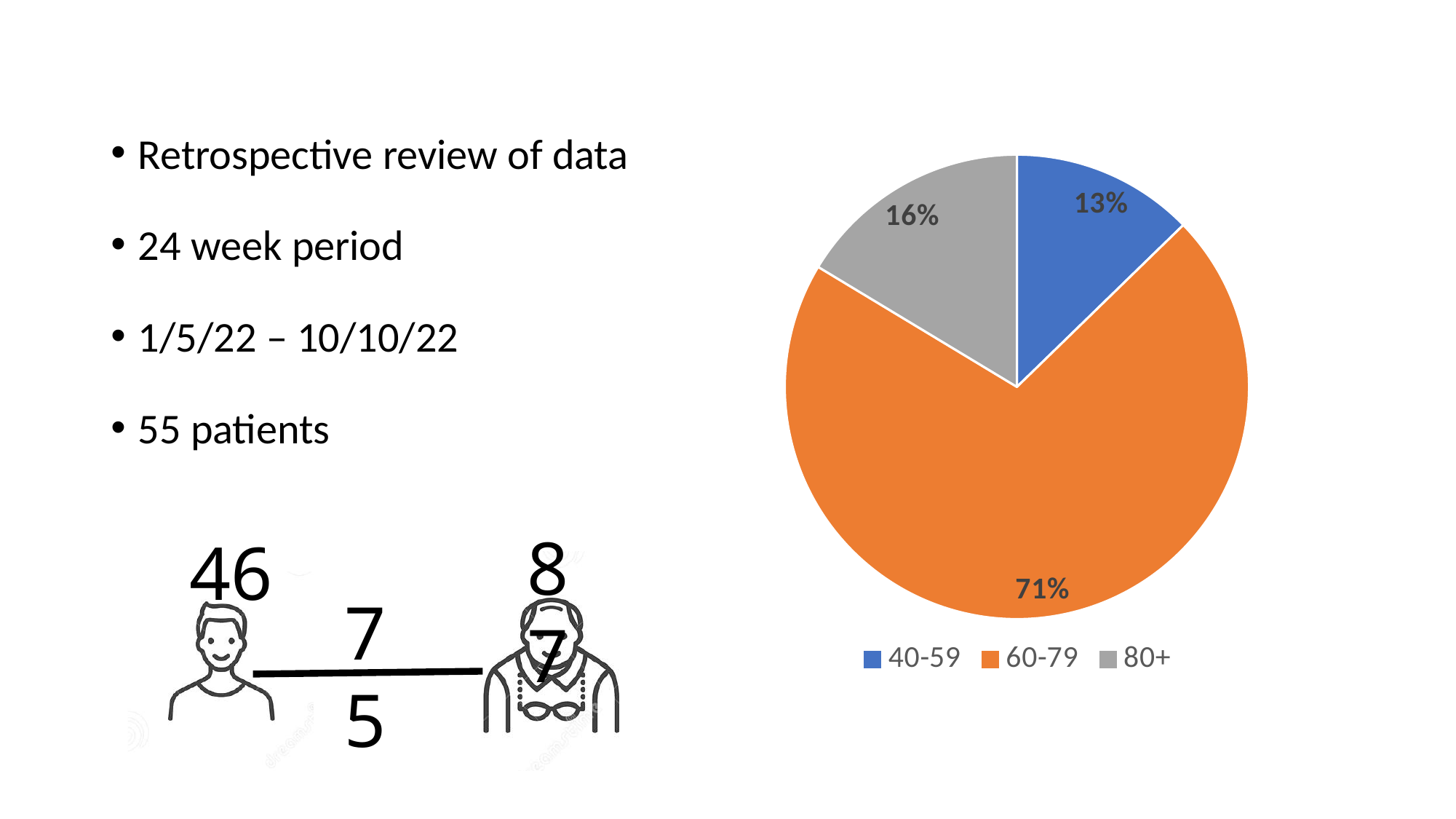
Which slice is larger, 80+ or 40-59? 80+ What share of the pie does the 80+ slice represent? 16% How many entries does the legend list? 3 What kind of chart is shown on the slide? pie chart How many slices does the pie chart have? 3 What colour is the 60-79 slice in the pie chart? orange What share of the pie does the 40-59 slice represent? 13% What is the difference in percentage points between the 60-79 slice and the 80+ slice? 55 Which age group is shown in grey in the pie chart? 80+ What share of the pie does the 60-79 slice represent? 71% Which age group has the smallest slice of the pie? 40-59 Which age group has the largest slice of the pie? 60-79